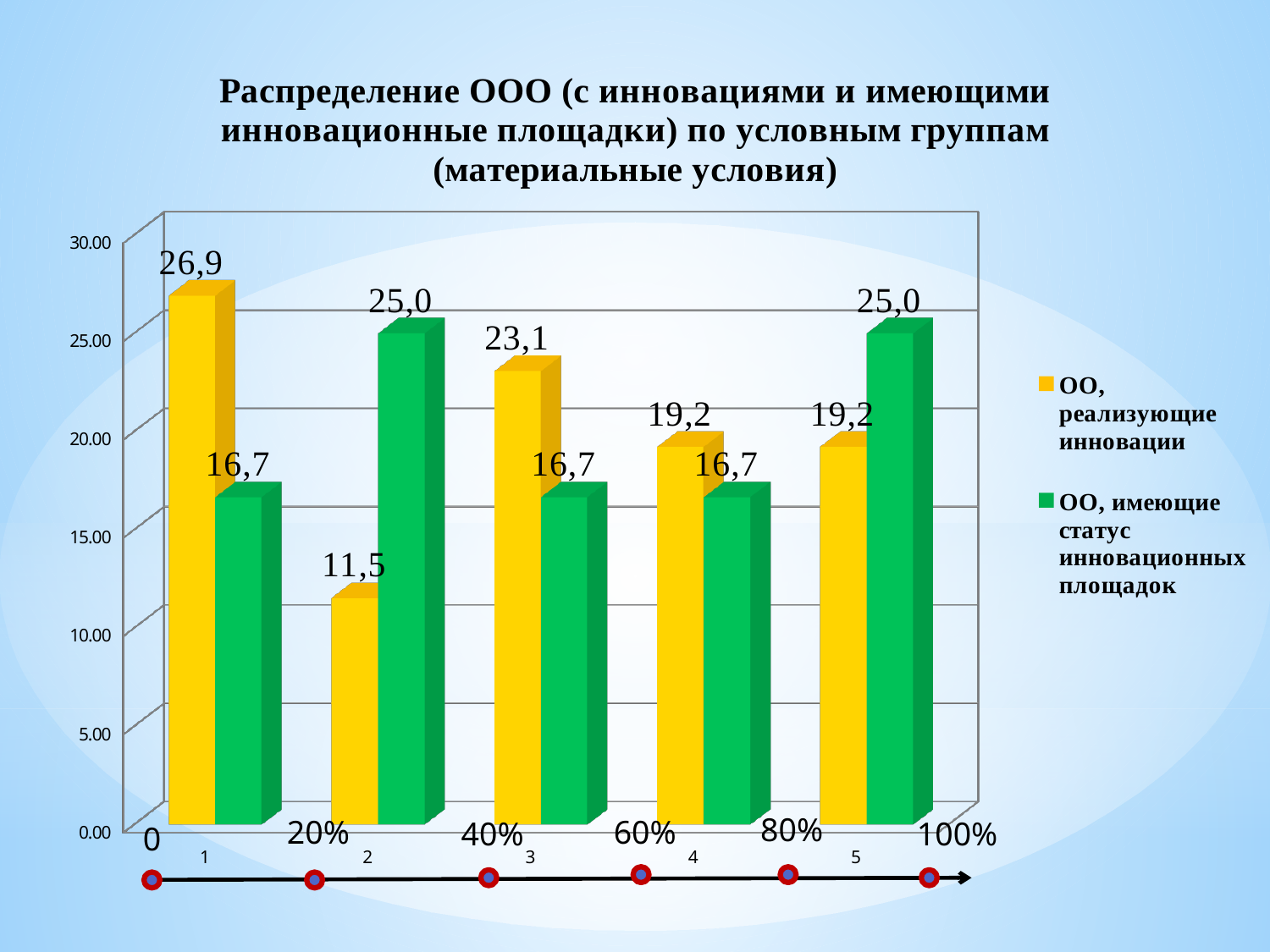
For category 4, which series has the larger value? ОО, реализующие инновации Is the value for category 2 in the series "ОО, реализующие инновации" greater or less than 15.00? less What colour represents the series "ОО, имеющие статус инновационных площадок"? green How many categories are shown on the x axis? 5 What is the difference between the two series for category 2? 13,5 What kind of chart is shown on the slide? bar chart How many series does the legend list? 2 What is the value for category 1 in the series "ОО, реализующие инновации"? 26,9 Which category has the lowest value in the series "ОО, реализующие инновации"? 2 What is the value for category 3 in the series "ОО, реализующие инновации"? 23,1 What is the value for category 2 in the series "ОО, имеющие статус инновационных площадок"? 25,0 Which category has the highest value in the series "ОО, реализующие инновации"? 1